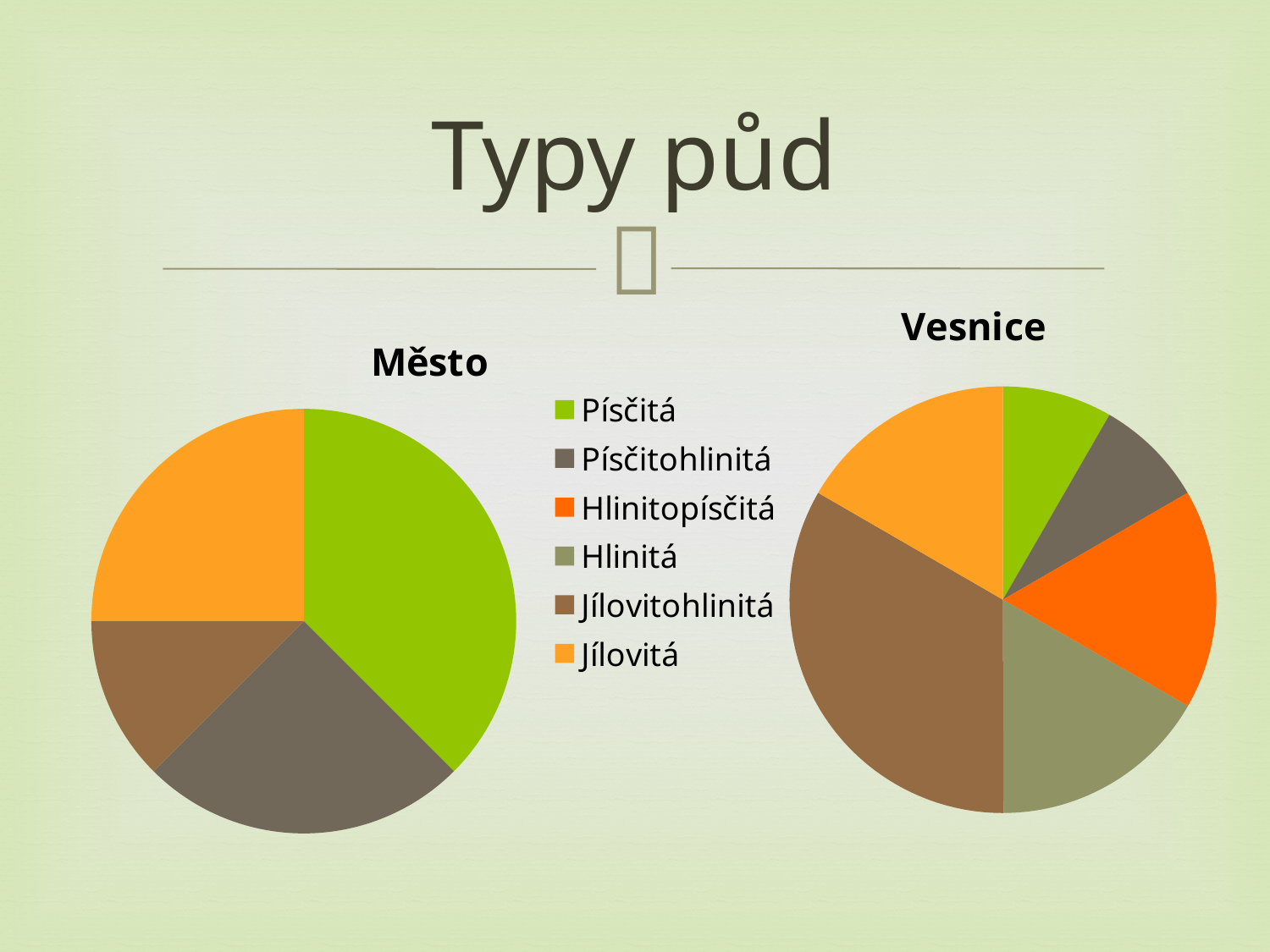
In the "Město" chart, which soil type has the smallest slice? Jílovitohlinitá What is the title of the slide containing the two pie charts? Typy půd What kind of chart is the "Město" chart? pie chart How many soil types does the legend list? 6 In the "Město" chart, which soil type has the largest slice? Písčitá What kind of chart is the "Vesnice" chart? pie chart In the "Vesnice" chart, which is larger: the slice for Jílovitohlinitá or the slice for Hlinitopísčitá? Jílovitohlinitá How many slices does the "Město" pie chart have? 4 How many slices does the "Vesnice" pie chart have? 6 In the "Vesnice" chart, which soil type has the largest slice? Jílovitohlinitá In the "Vesnice" chart, which is larger: the slice for Jílovitá or the slice for Písčitá? Jílovitá In the "Město" chart, which is larger: the slice for Písčitá or the slice for Písčitohlinitá? Písčitá